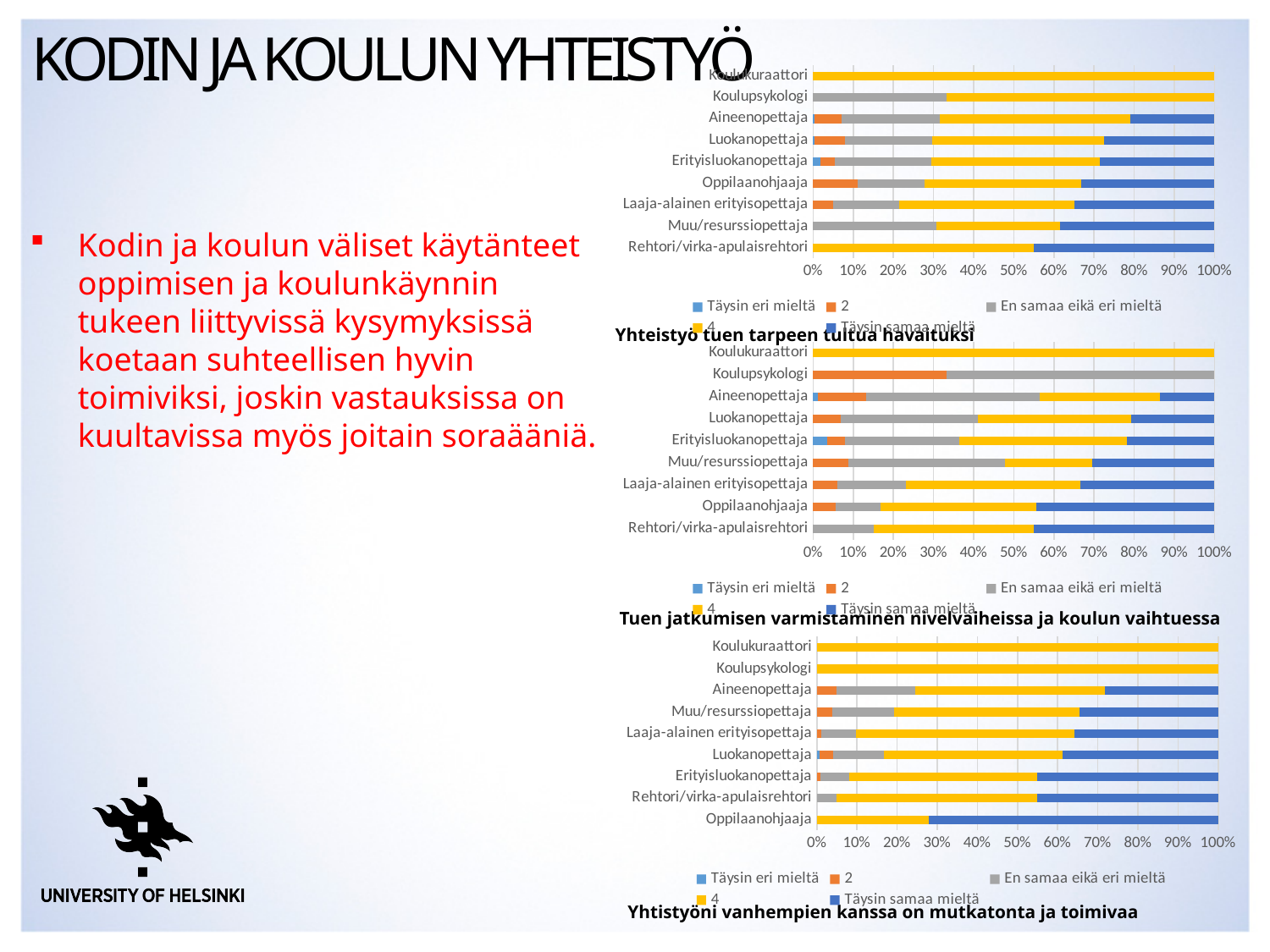
In the middle chart, is the '4' share for Koulupsykologi greater or less than 50%? less What is the highest value shown on the horizontal axis of the bottom chart? 100% How many categories (roles) are listed on the vertical axis of the top chart? 9 How many series does the legend of the middle chart list? 5 In the top chart, is the '4' share for Koulukuraattori greater or less than 90%? greater What is the first legend entry of the top chart? Täysin eri mieltä In the bottom chart, which category has the largest 'Täysin samaa mieltä' share? Oppilaanohjaaja In the bottom chart, is the '4' share for Koulukuraattori greater or less than 90%? greater Which category appears at the bottom of the vertical axis in the bottom chart? Oppilaanohjaaja What kind of chart is the top chart on the slide? Stacked bar chart